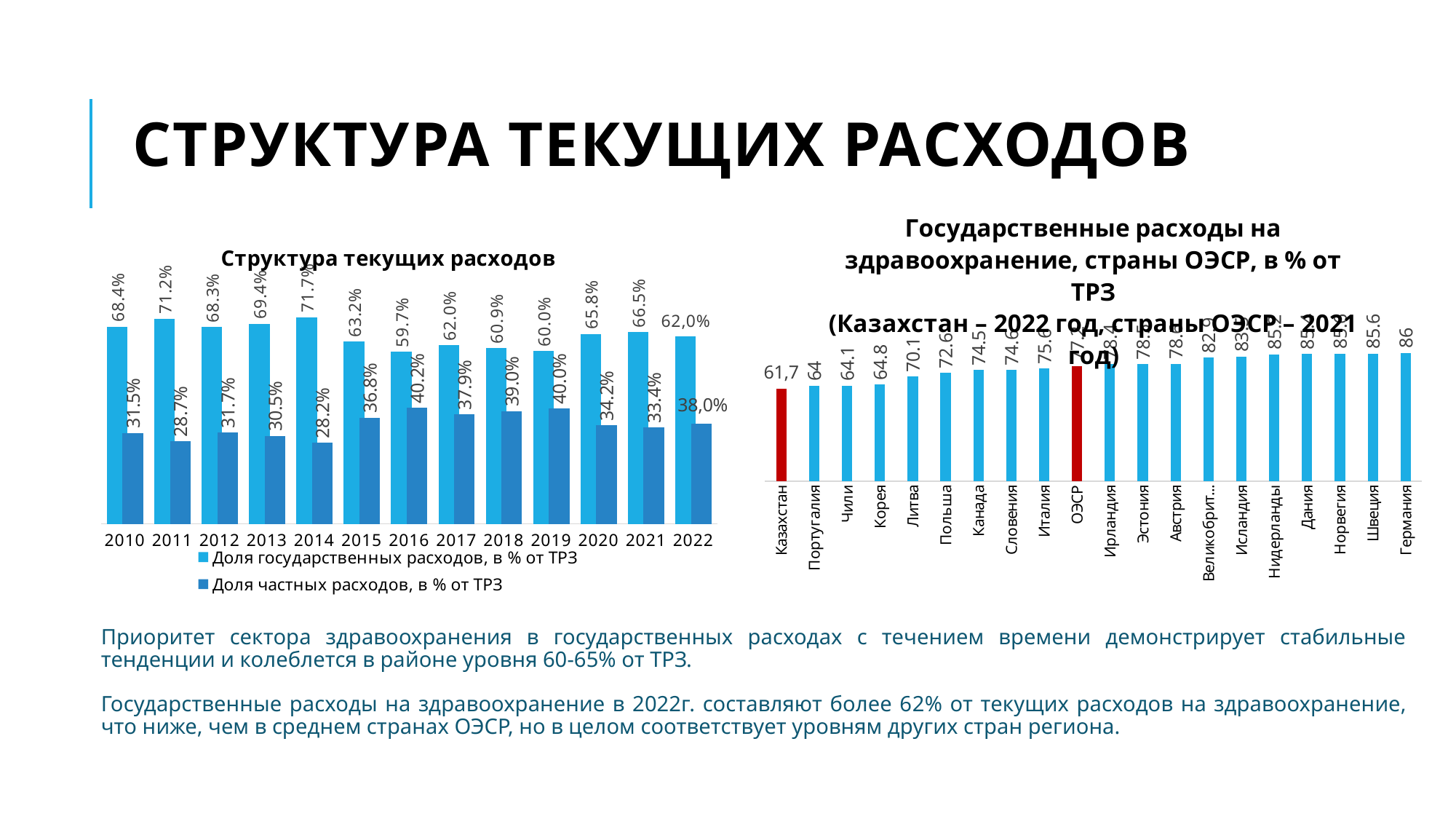
In the left chart 'Структура текущих расходов', what is the difference between the public share and the private share in 2010? 36.9 percentage points How many years are shown on the x axis of the left chart 'Структура текущих расходов'? 13 What kind of chart is the left chart titled 'Структура текущих расходов'? Bar chart In the right chart 'Государственные расходы на здравоохранение, страны ОЭСР', what is the value for Германия? 86 How many series does the legend of the left chart 'Структура текущих расходов' list? 2 In the left chart 'Структура текущих расходов', which year has the lowest value for 'Доля государственных расходов, в % от ТРЗ'? 2016 In the right chart 'Государственные расходы на здравоохранение, страны ОЭСР', which country has the lowest value? Казахстан In the right chart 'Государственные расходы на здравоохранение, страны ОЭСР', what is the value for Казахстан? 61,7 In the left chart 'Структура текущих расходов', what is the value of 'Доля частных расходов, в % от ТРЗ' for 2019? 40.0% In the right chart 'Государственные расходы на здравоохранение, страны ОЭСР', which is larger, the value for Литва or the value for Польша? Польша In the left chart 'Структура текущих расходов', what is the value of 'Доля государственных расходов, в % от ТРЗ' for 2014? 71.7% In the right chart 'Государственные расходы на здравоохранение, страны ОЭСР', which two bars are coloured red? Казахстан and ОЭСР